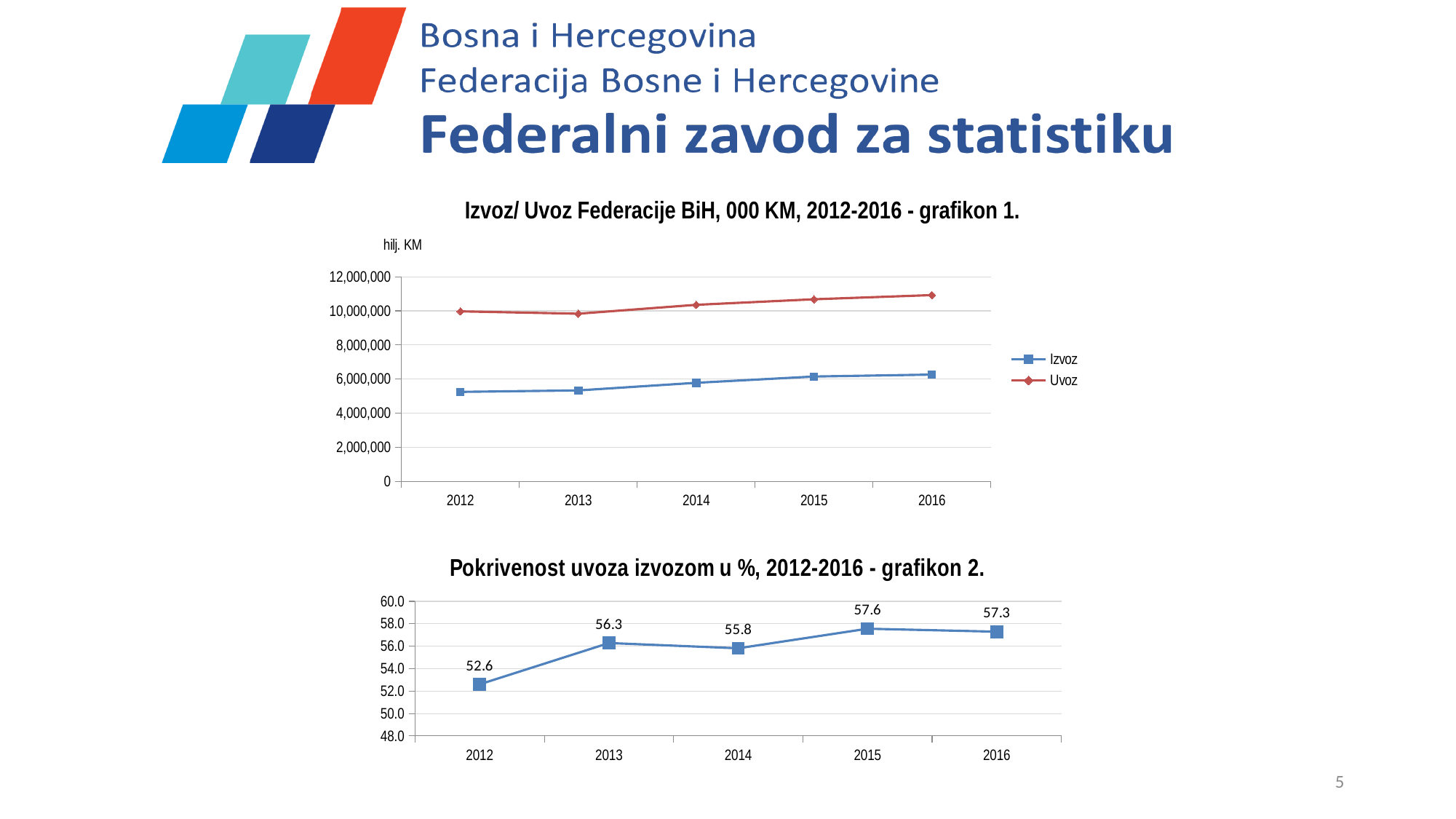
In the chart 'Pokrivenost uvoza izvozom u %, 2012-2016 - grafikon 2.', which is larger, the value for 2013 or the value for 2014? 2013 What kind of chart is 'Izvoz/ Uvoz Federacije BiH, 000 KM, 2012-2016 - grafikon 1.'? Line chart In the chart 'Izvoz/ Uvoz Federacije BiH, 000 KM, 2012-2016 - grafikon 1.', is the Uvoz value for 2016 greater or less than 10,000,000? greater In the chart 'Pokrivenost uvoza izvozom u %, 2012-2016 - grafikon 2.', what is the value for 2015? 57.6 In the chart 'Izvoz/ Uvoz Federacije BiH, 000 KM, 2012-2016 - grafikon 1.', is the Izvoz value for 2012 greater or less than 6,000,000? less In the chart 'Pokrivenost uvoza izvozom u %, 2012-2016 - grafikon 2.', what is the value for 2012? 52.6 In the chart 'Pokrivenost uvoza izvozom u %, 2012-2016 - grafikon 2.', which year has the lowest value? 2012 In the chart 'Izvoz/ Uvoz Federacije BiH, 000 KM, 2012-2016 - grafikon 1.', which series is higher in every year, Izvoz or Uvoz? Uvoz In the chart 'Pokrivenost uvoza izvozom u %, 2012-2016 - grafikon 2.', which year has the highest value? 2015 In the chart 'Pokrivenost uvoza izvozom u %, 2012-2016 - grafikon 2.', what is the difference between the 2015 and 2012 values? 5.0 In the chart 'Pokrivenost uvoza izvozom u %, 2012-2016 - grafikon 2.', how many years are plotted? 5 In the chart 'Izvoz/ Uvoz Federacije BiH, 000 KM, 2012-2016 - grafikon 1.', how many series does the legend list? 2